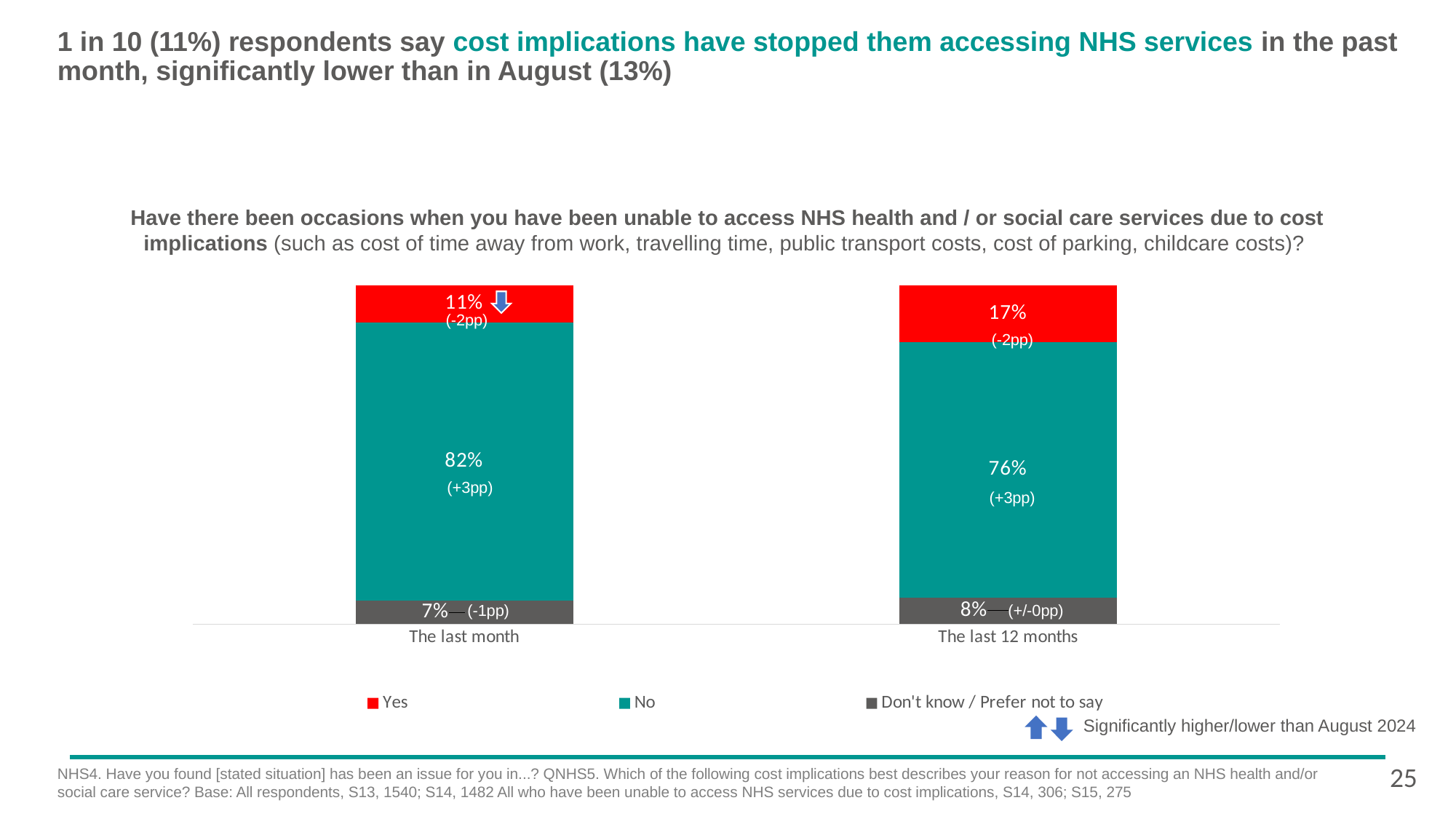
What percentage of respondents answered "No" for the last 12 months? 76% How many series does the chart legend list? 3 Which time period has the lower "No" percentage? The last 12 months What percentage of respondents answered "No" for the last month? 82% What percentage of respondents answered "Yes" for the last month? 11% What percentage of respondents answered "Don't know / Prefer not to say" for the last 12 months? 8% What is the difference between the "Yes" percentages for the last 12 months and the last month? 6 percentage points Which time period has the higher "Yes" percentage? The last 12 months Is the "No" percentage larger for the last month or the last 12 months? The last month What percentage of respondents answered "Yes" for the last 12 months? 17% What type of chart is shown on the slide? Stacked bar chart How many categories are shown on the x axis of the chart? 2